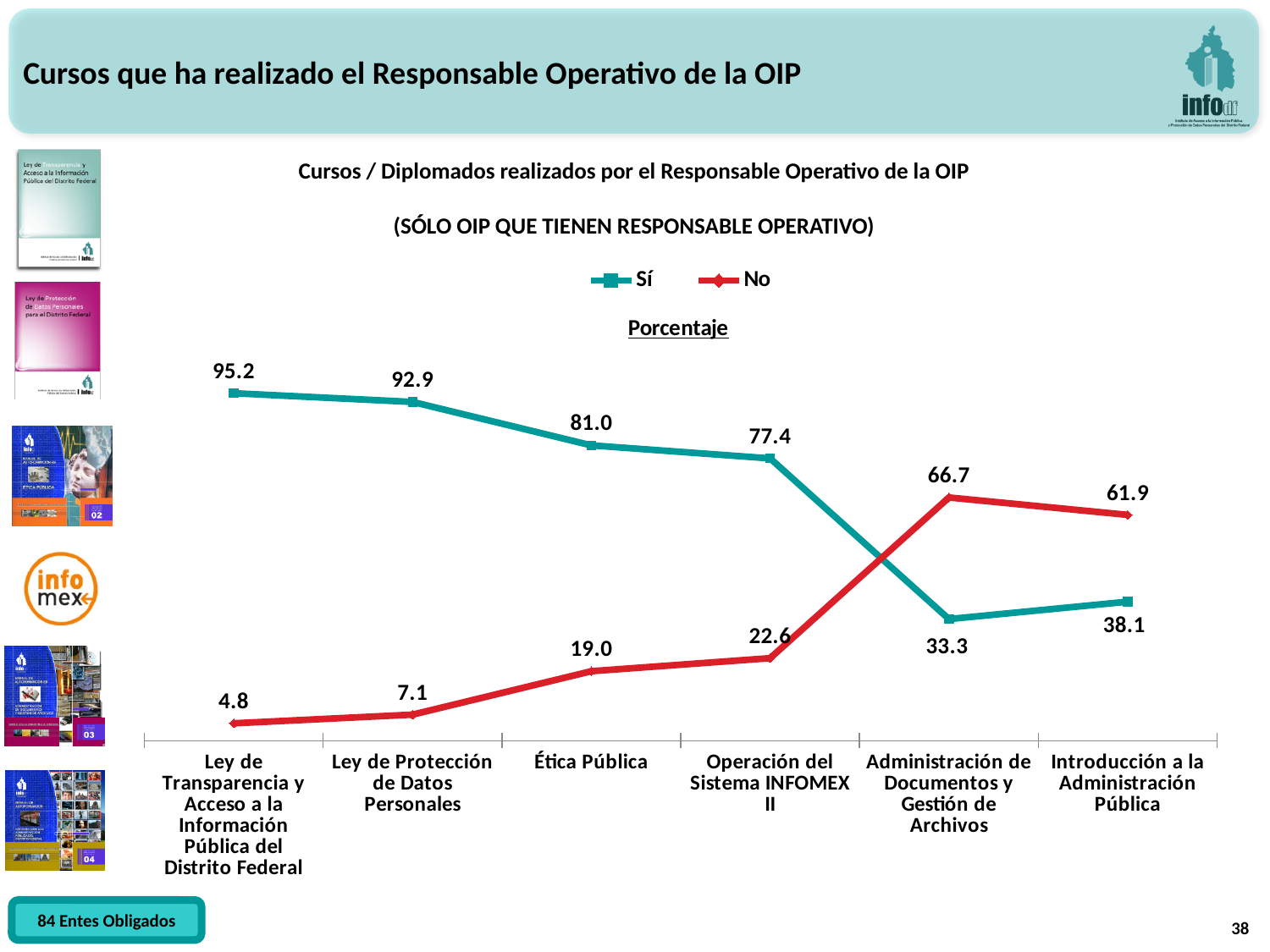
For Administración de Documentos y Gestión de Archivos, which is larger, the 'Sí' value or the 'No' value? No Which category has the highest 'Sí' value? Ley de Transparencia y Acceso a la Información Pública del Distrito Federal What is the difference between the 'Sí' and 'No' values for Operación del Sistema INFOMEX II? 54.8 What is the 'No' value for Administración de Documentos y Gestión de Archivos? 66.7 Which category has the lowest 'No' value? Ley de Transparencia y Acceso a la Información Pública del Distrito Federal How many categories are shown on the x axis? 6 What is the 'Sí' value for Ética Pública? 81.0 What kind of chart is shown on the slide? Line chart How many series does the legend list? 2 What is the 'Sí' value for Introducción a la Administración Pública? 38.1 Does the 'Sí' series generally rise or fall from Ley de Transparencia to Administración de Documentos y Gestión de Archivos? Fall What colour is the 'No' series line? Red